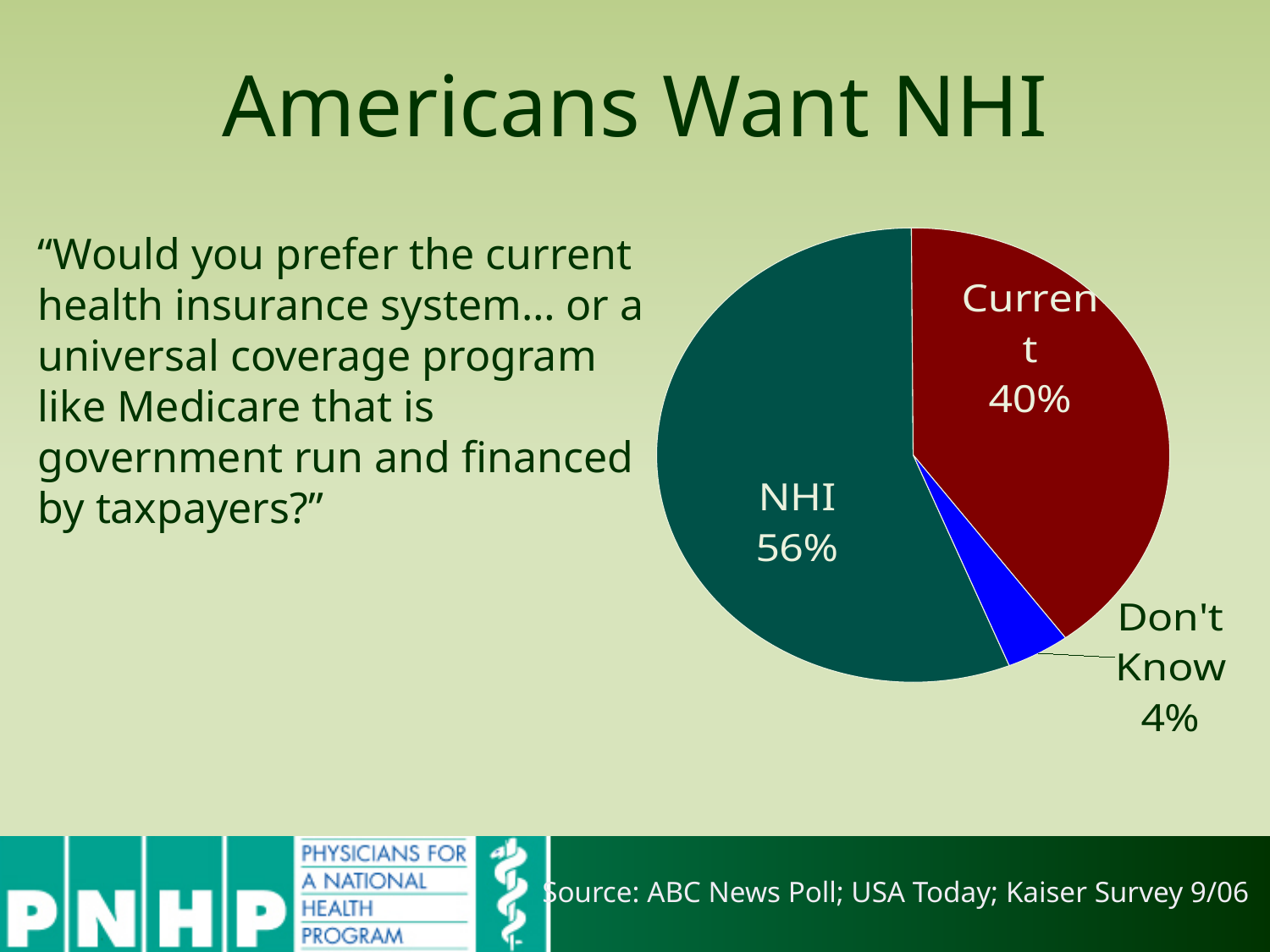
What is the title of the slide containing the pie chart? Americans Want NHI What share of respondents preferred NHI? 56% What is the difference in percentage points between NHI and Current? 16 Which slice of the pie is the largest? NHI What share of respondents answered Don't Know? 4% Which slice of the pie is the smallest? Don't Know How many slices does the pie chart have? 3 What colour is the NHI slice? dark teal green What is the combined share of NHI and Current? 96% What share of respondents preferred the Current system? 40% Which is larger, the share for Current or the share for Don't Know? Current What kind of chart is shown on the slide? pie chart